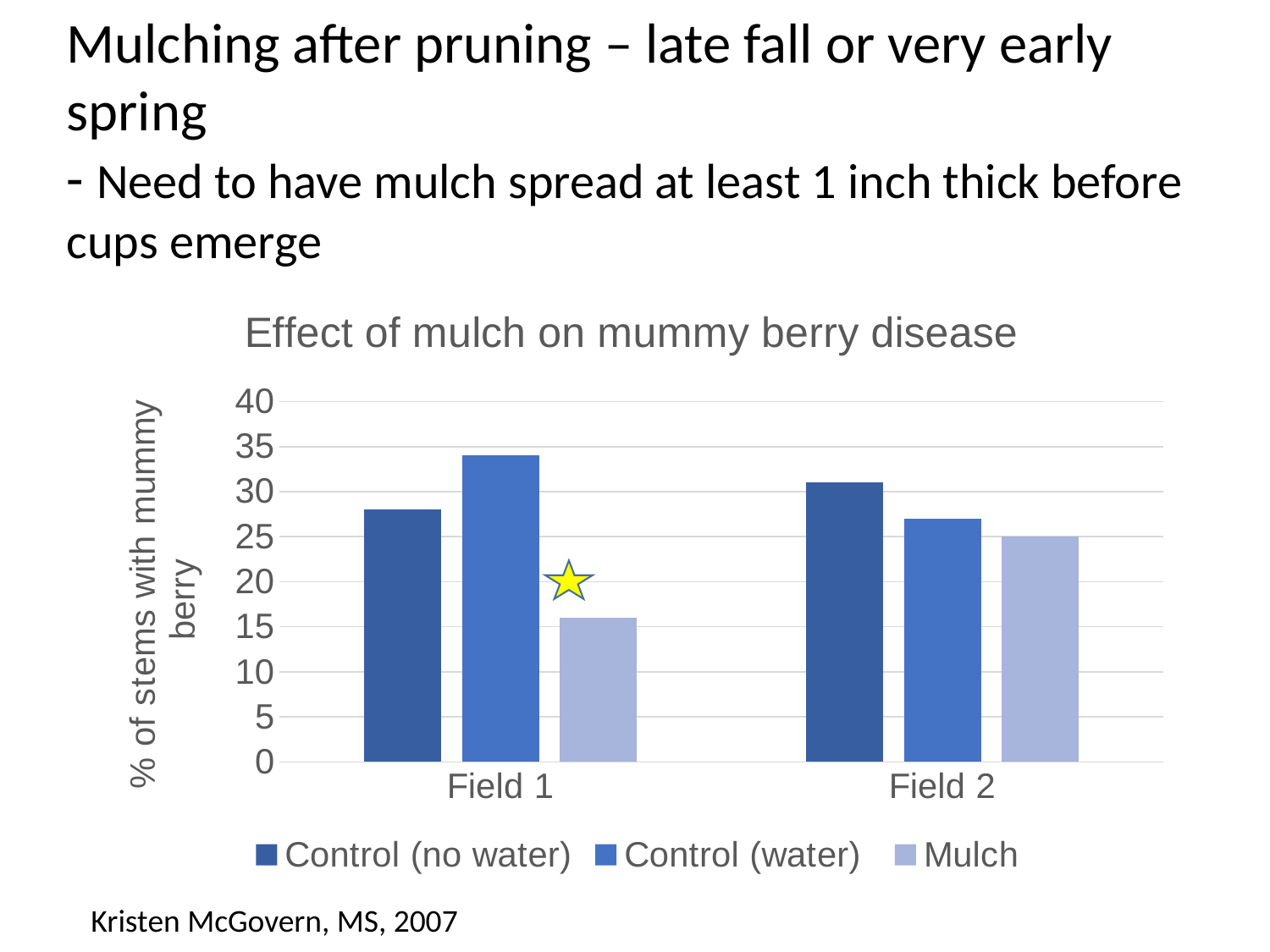
Is the Mulch value for Field 1 greater or less than 20? less What is the label of the vertical axis? % of stems with mummy berry Which series has the lowest value in Field 1? Mulch How many series does the legend list? 3 Which series has the highest value in Field 1? Control (water) What kind of chart is shown on the slide? bar chart Which series has the highest value in Field 2? Control (no water) Which field has the larger Mulch value, Field 1 or Field 2? Field 2 How many field categories are shown on the x axis? 2 What is the title of the chart? Effect of mulch on mummy berry disease Is the Control (water) value for Field 2 greater or less than 30? less Is the Control (water) value for Field 1 greater or less than 30? greater